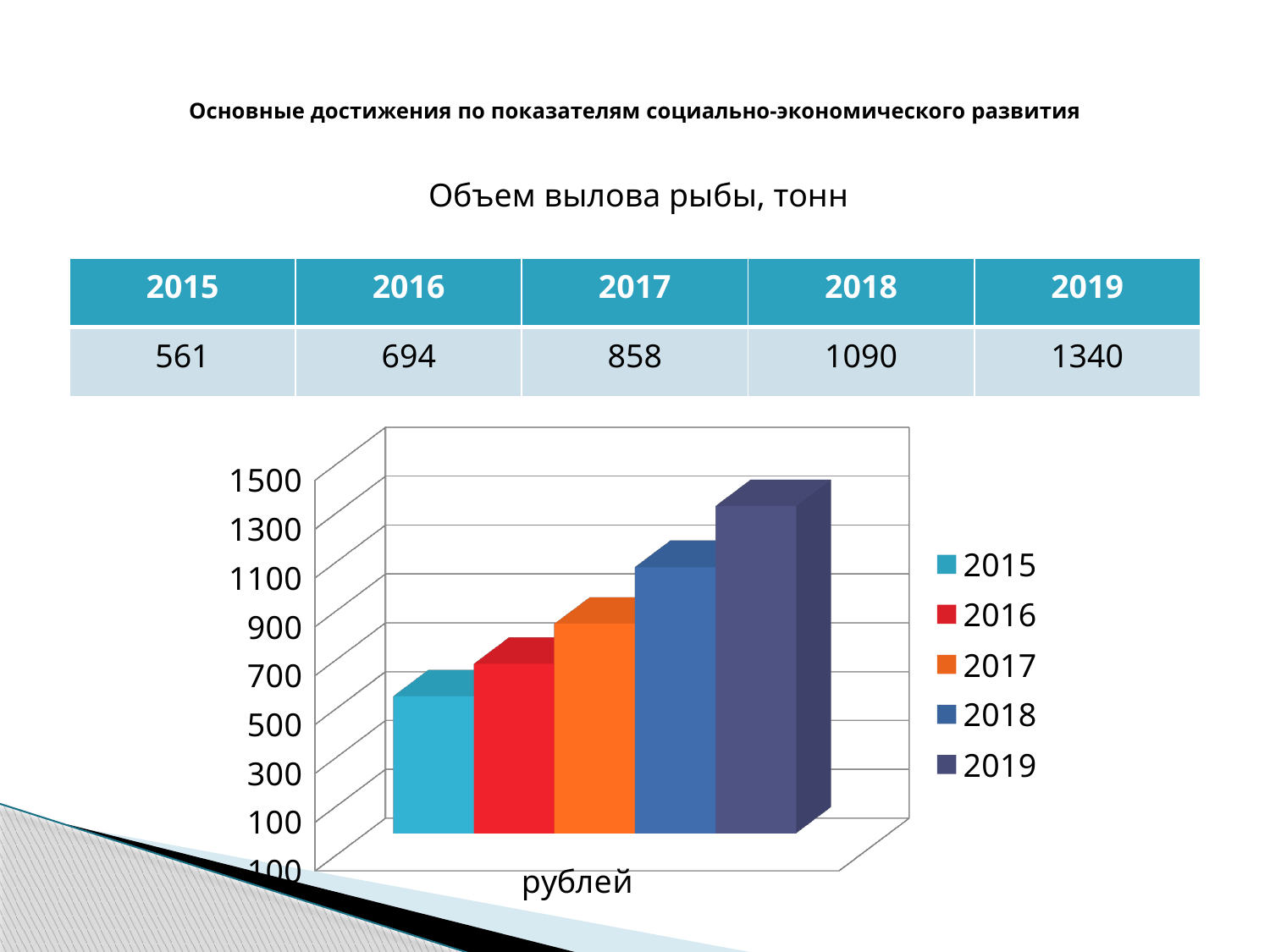
Do the values rise or fall from 2015 to 2019? rise What is the value for 2019 shown on the slide? 1340 What is the value for 2015 shown on the slide? 561 Which year has the highest value in the chart? 2019 Is the value for 2018 greater or less than 900? greater Which is larger, the value for 2017 or the value for 2016? 2017 What kind of chart is shown on the slide? bar chart Which year has the lowest value in the chart? 2015 How many series does the legend list? 5 What is the difference between the values for 2016 and 2015? 133 What is the value for 2017 shown on the slide? 858 What is the difference between the values for 2019 and 2018? 250